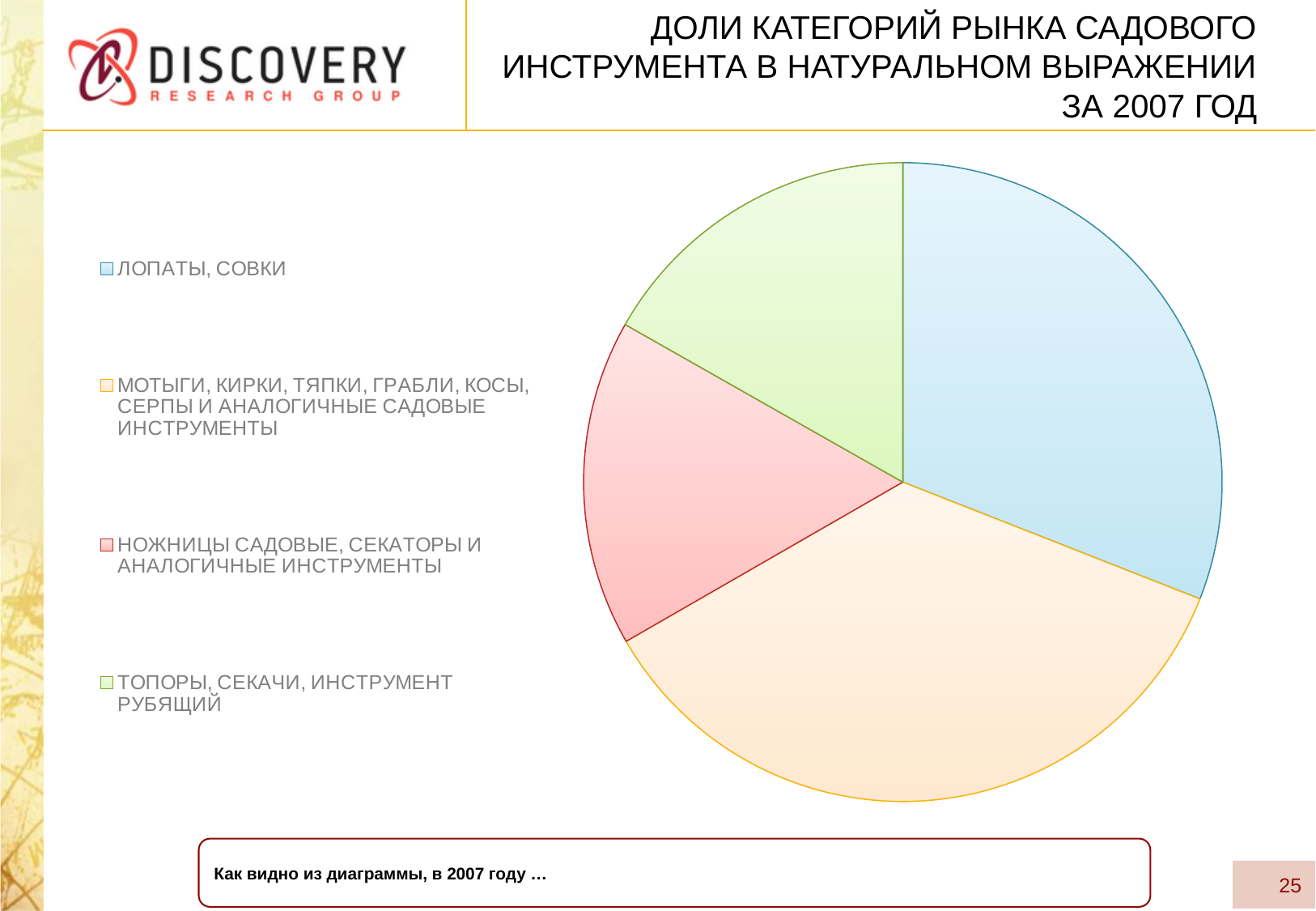
Which category has the largest share of the pie chart? МОТЫГИ, КИРКИ, ТЯПКИ, ГРАБЛИ, КОСЫ, СЕРПЫ И АНАЛОГИЧНЫЕ САДОВЫЕ ИНСТРУМЕНТЫ Which slice is larger: ЛОПАТЫ, СОВКИ or НОЖНИЦЫ САДОВЫЕ, СЕКАТОРЫ И АНАЛОГИЧНЫЕ ИНСТРУМЕНТЫ? ЛОПАТЫ, СОВКИ Which slice is larger: МОТЫГИ, КИРКИ, ТЯПКИ, ГРАБЛИ, КОСЫ, СЕРПЫ И АНАЛОГИЧНЫЕ САДОВЫЕ ИНСТРУМЕНТЫ or ЛОПАТЫ, СОВКИ? МОТЫГИ, КИРКИ, ТЯПКИ, ГРАБЛИ, КОСЫ, СЕРПЫ И АНАЛОГИЧНЫЕ САДОВЫЕ ИНСТРУМЕНТЫ Which slice is larger: ЛОПАТЫ, СОВКИ or ТОПОРЫ, СЕКАЧИ, ИНСТРУМЕНТ РУБЯЩИЙ? ЛОПАТЫ, СОВКИ What year does the chart on the slide refer to? 2007 How many categories (slices) does the pie chart have? 4 How many entries does the legend of the pie chart list? 4 What kind of chart is shown on the slide? pie chart What colour is the slice for ЛОПАТЫ, СОВКИ in the pie chart? blue